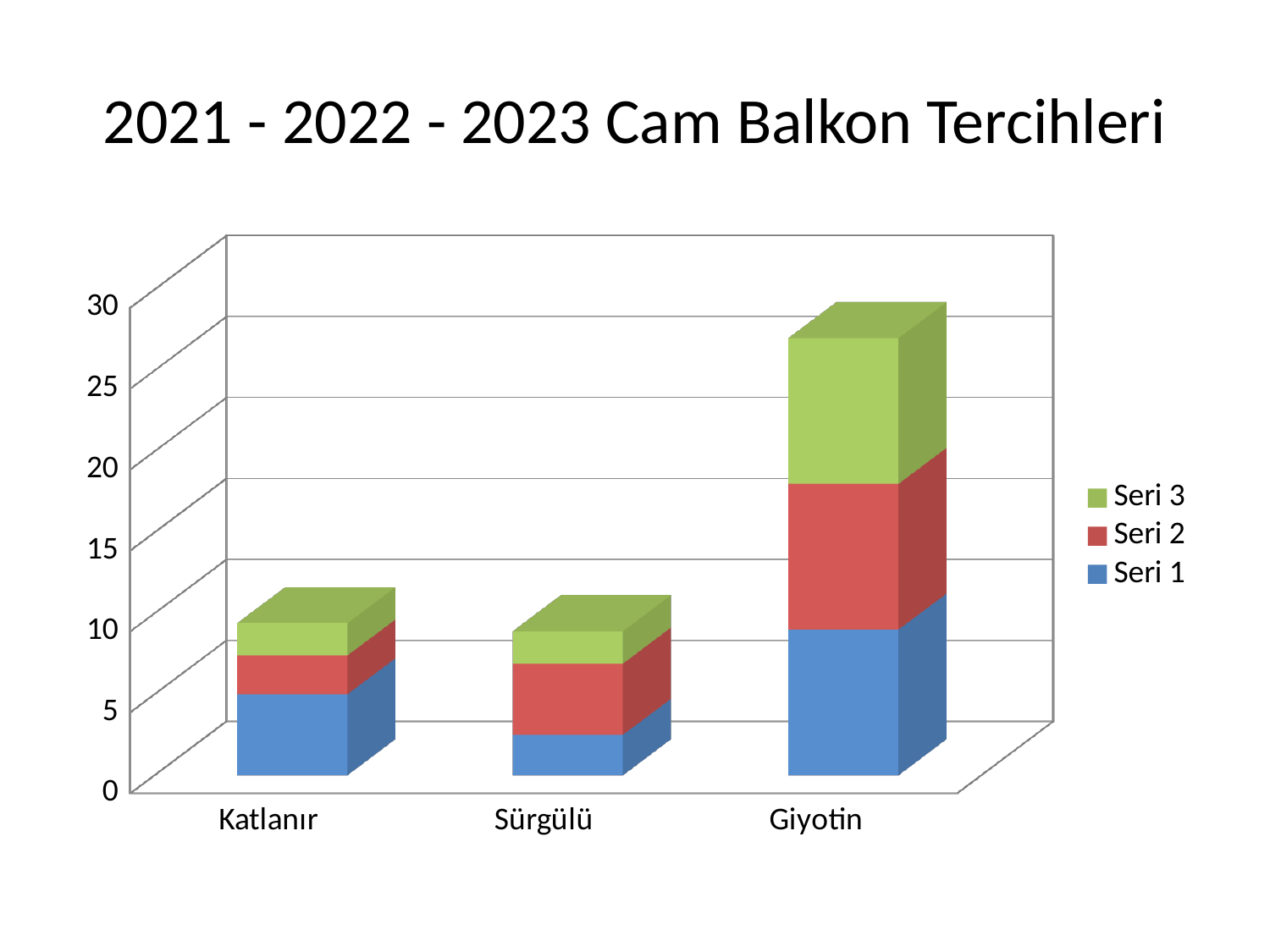
What is the title of the slide containing the chart? 2021 - 2022 - 2023 Cam Balkon Tercihleri Which is larger, the Seri 1 value for Giyotin or the Seri 1 value for Katlanır? Giyotin Is the total stacked value for Sürgülü greater or less than 15? less Is the Seri 1 value for Sürgülü greater or less than 5? less How many categories are shown on the x axis of the chart? 3 How many series does the legend list? 3 Which category has the highest total stacked bar? Giyotin Which series is shown in green in the chart? Seri 3 What kind of chart is shown on the slide? Stacked bar chart Is the total stacked value for Giyotin greater or less than 25? greater